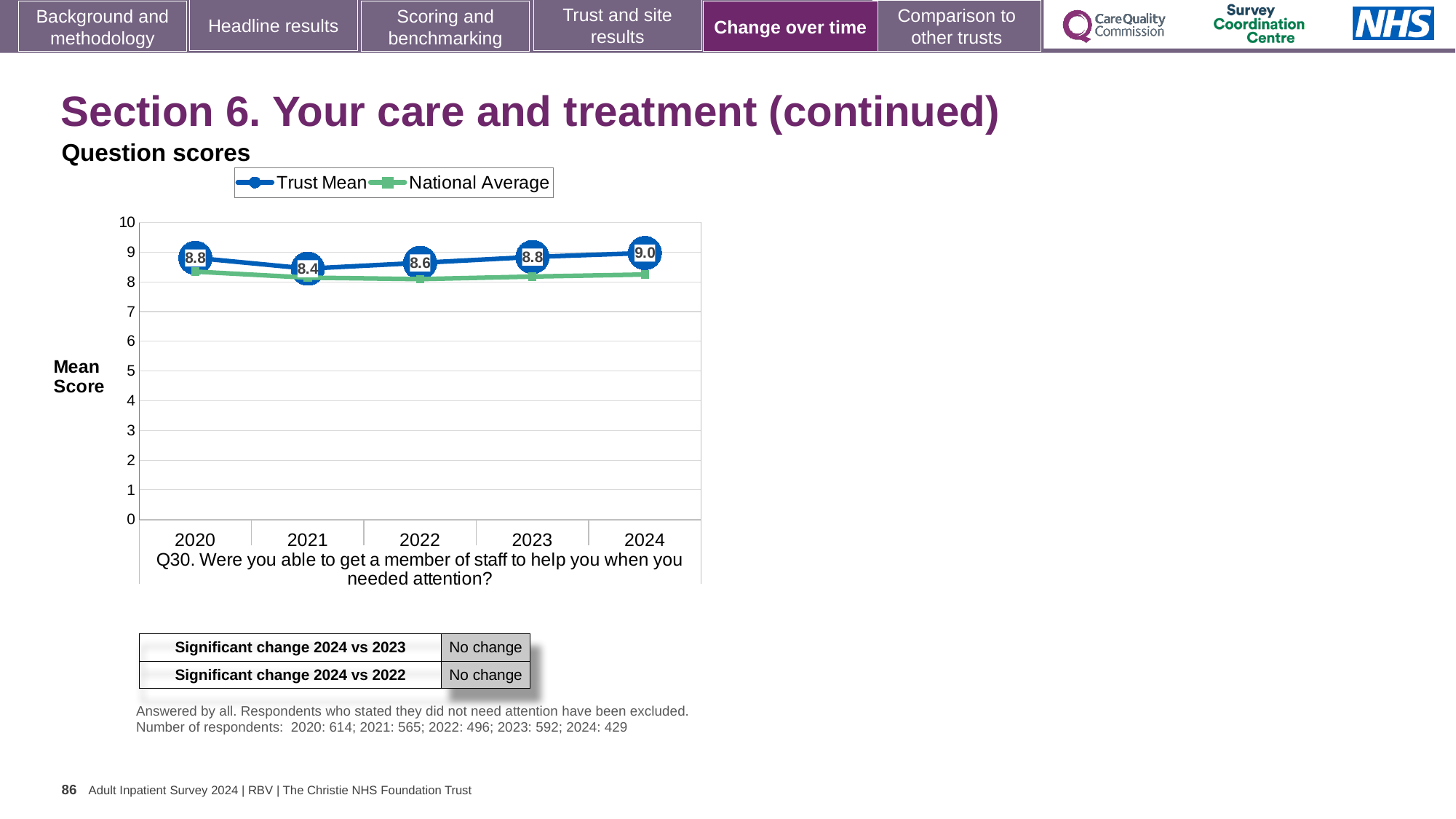
What kind of chart is shown on the slide? Line chart What is the Trust Mean score for 2022? 8.6 What is the Trust Mean score for 2021? 8.4 In which year is the Trust Mean score lowest? 2021 Which is larger, the Trust Mean score in 2020 or in 2021? 2020 In which year is the Trust Mean score highest? 2024 What is the Trust Mean score for 2024? 9.0 Is the National Average value for 2024 greater or less than 9? less How many years are shown on the x axis of the chart? 5 Does the Trust Mean score rise or fall from 2021 to 2024? Rise What is the difference between the Trust Mean score in 2024 and in 2021? 0.6 How many series does the chart legend list? 2